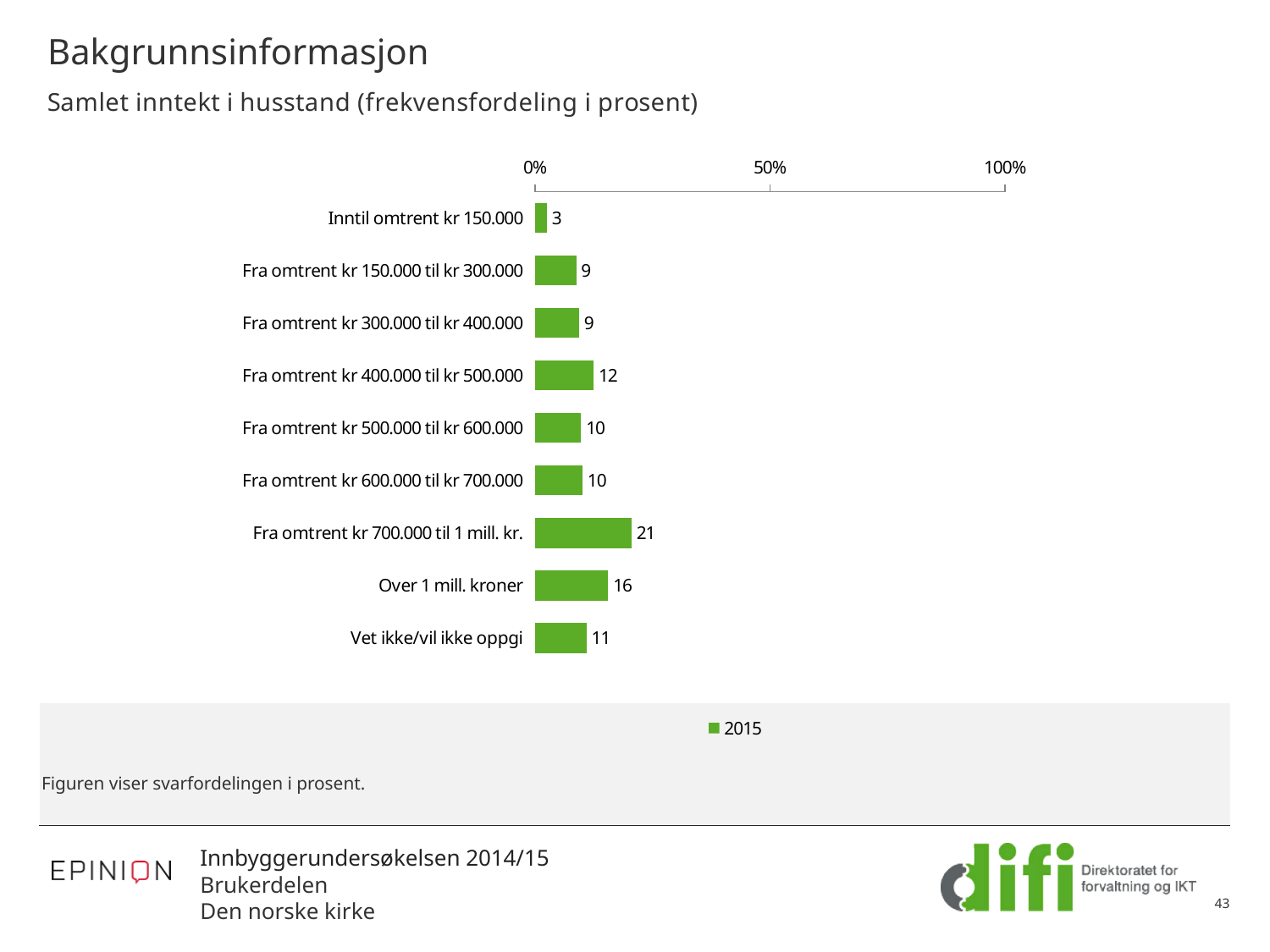
What is the value for 'Vet ikke/vil ikke oppgi'? 11 What is the difference between the values for 'Fra omtrent kr 700.000 til 1 mill. kr.' and 'Over 1 mill. kroner'? 5 Which is larger, the value for 'Fra omtrent kr 400.000 til kr 500.000' or the value for 'Fra omtrent kr 500.000 til kr 600.000'? Fra omtrent kr 400.000 til kr 500.000 Which category has the lowest value? Inntil omtrent kr 150.000 What is the value for 'Inntil omtrent kr 150.000'? 3 Is the value for 'Fra omtrent kr 700.000 til 1 mill. kr.' greater or less than 50%? less How many series does the legend list? 1 How many categories are shown in the chart? 9 What is the value for 'Over 1 mill. kroner'? 16 What is the value for 'Fra omtrent kr 700.000 til 1 mill. kr.'? 21 What kind of chart is shown on the slide? bar chart Which category has the highest value? Fra omtrent kr 700.000 til 1 mill. kr.